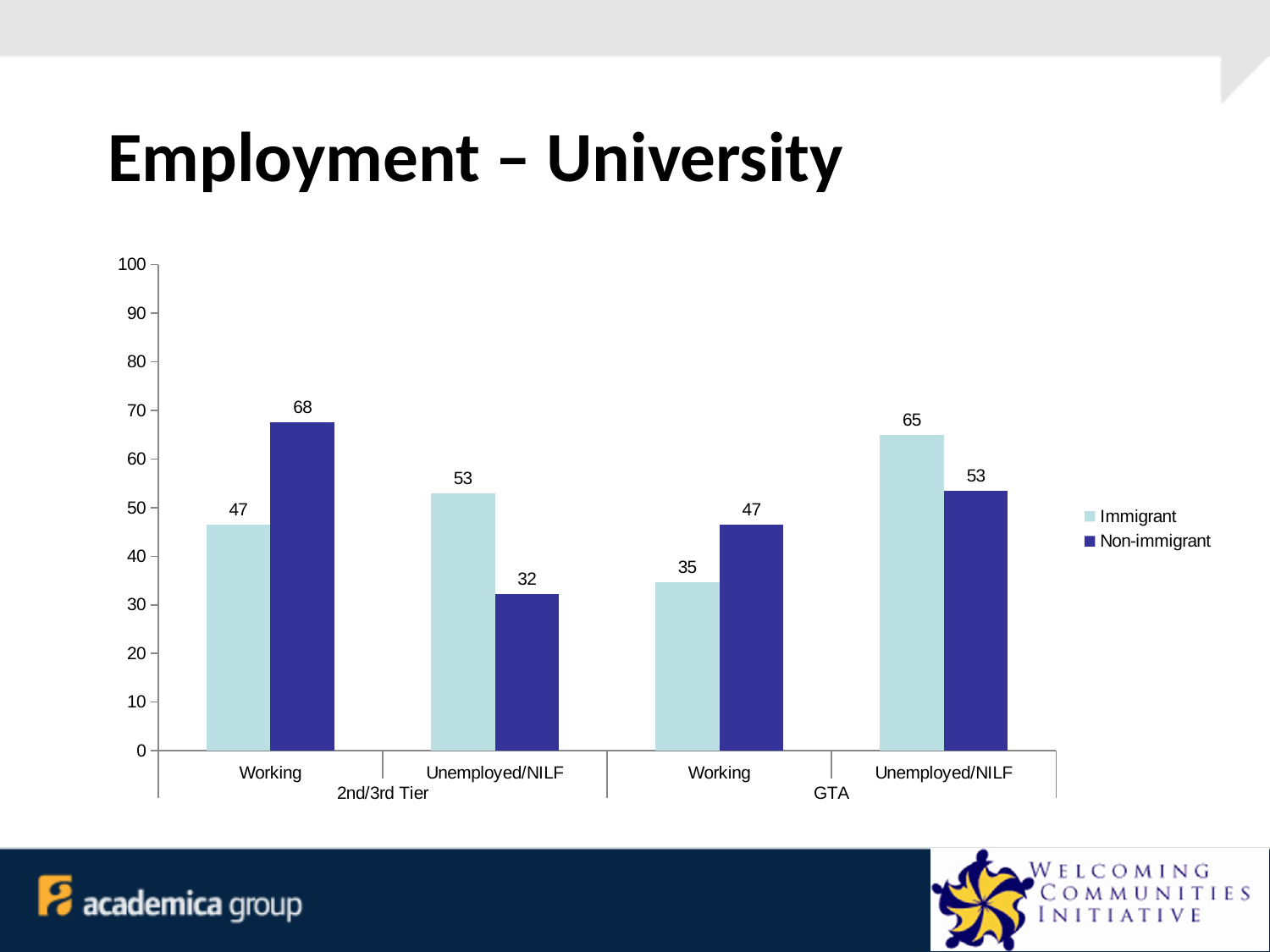
What is the Non-immigrant value for Unemployed/NILF in the GTA group? 53 Which bar has the highest value on the chart? Non-immigrant, Working, 2nd/3rd Tier (68) What is the title of the slide? Employment – University What is the difference between the Immigrant and Non-immigrant values for Unemployed/NILF in the GTA group? 12 What is the Immigrant value for Working in the 2nd/3rd Tier group? 47 Is the Immigrant value for Unemployed/NILF in the GTA group greater or less than 60? greater Which bar has the lowest value on the chart? Non-immigrant, Unemployed/NILF, 2nd/3rd Tier (32) What is the Immigrant value for Working in the GTA group? 35 For Working in the GTA group, which is larger: the Immigrant value or the Non-immigrant value? Non-immigrant What is the difference between the Non-immigrant and Immigrant values for Working in the 2nd/3rd Tier group? 21 What kind of chart is shown on the slide? Bar chart How many series does the legend list? 2